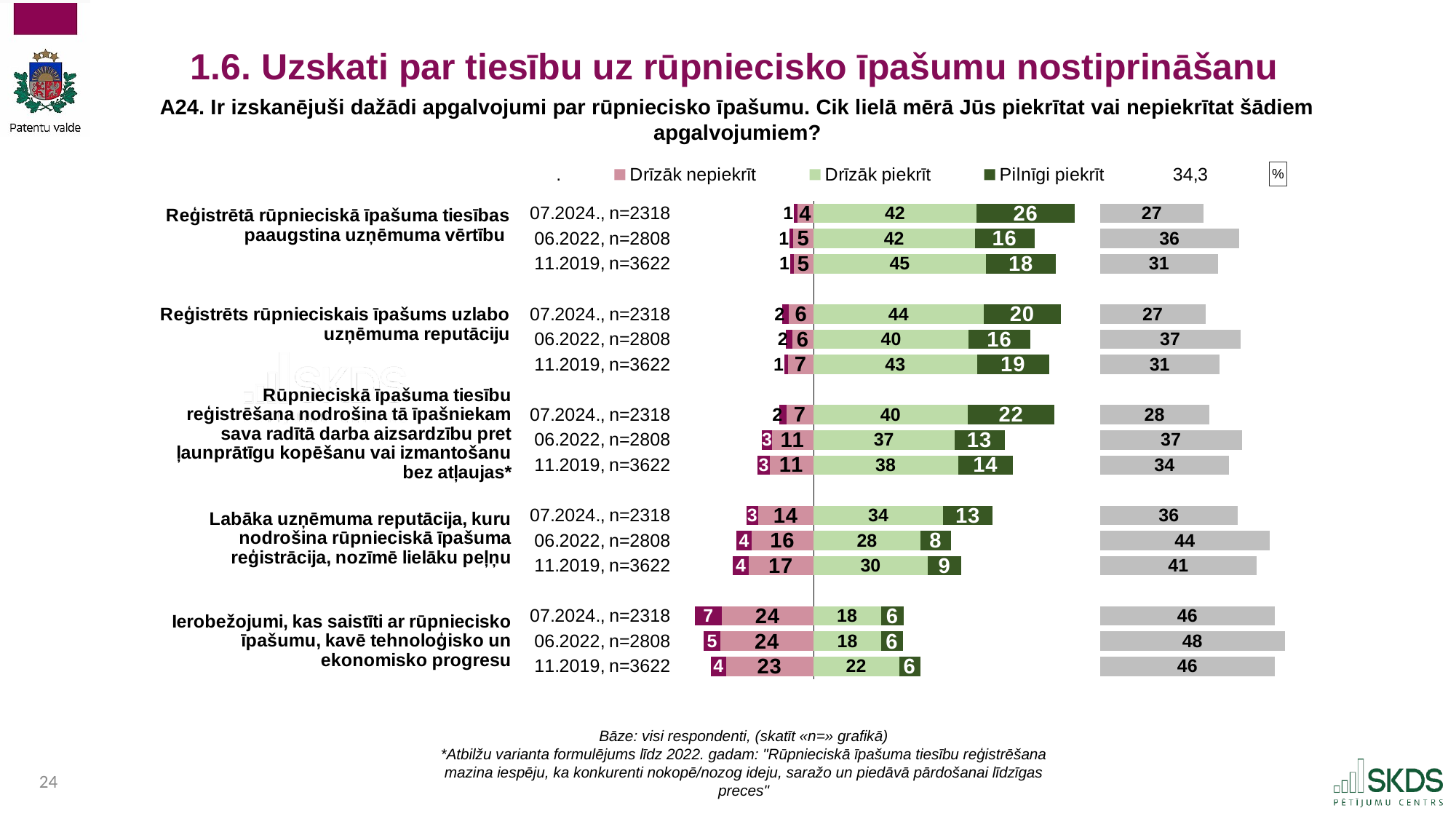
What is the difference between the "Pilnīgi piekrīt" values for "Reģistrētā rūpnieciskā īpašuma tiesības paaugstina uzņēmuma vērtību" in 07.2024 and 06.2022? 10 How many series does the legend list? 3 What is the "Drīzāk nepiekrīt" value for "Labāka uzņēmuma reputācija, kuru nodrošina rūpnieciskā īpašuma reģistrācija, nozīmē lielāku peļņu" in the 06.2022 wave? 16 For "Reģistrēts rūpnieciskais īpašums uzlabo uzņēmuma reputāciju", is the "Drīzāk piekrīt" value larger in 07.2024 or in 06.2022? 07.2024 For "Labāka uzņēmuma reputācija, kuru nodrošina rūpnieciskā īpašuma reģistrācija, nozīmē lielāku peļņu", which survey wave has the lowest "Pilnīgi piekrīt" value? 06.2022 What kind of chart is shown on the slide? Stacked bar chart How many statements are shown in the chart? 5 What colour represents "Pilnīgi piekrīt" in the legend? Dark green What is the "Pilnīgi piekrīt" value for "Reģistrētā rūpnieciskā īpašuma tiesības paaugstina uzņēmuma vērtību" in the 07.2024 wave? 26 What is the combined "Drīzāk piekrīt" and "Pilnīgi piekrīt" value for "Reģistrēts rūpnieciskais īpašums uzlabo uzņēmuma reputāciju" in the 07.2024 wave? 64 What is the "Drīzāk piekrīt" value for "Ierobežojumi, kas saistīti ar rūpniecisko īpašumu, kavē tehnoloģisko un ekonomisko progresu" in the 11.2019 wave? 22 For "Reģistrētā rūpnieciskā īpašuma tiesības paaugstina uzņēmuma vērtību", which survey wave has the highest "Pilnīgi piekrīt" value? 07.2024